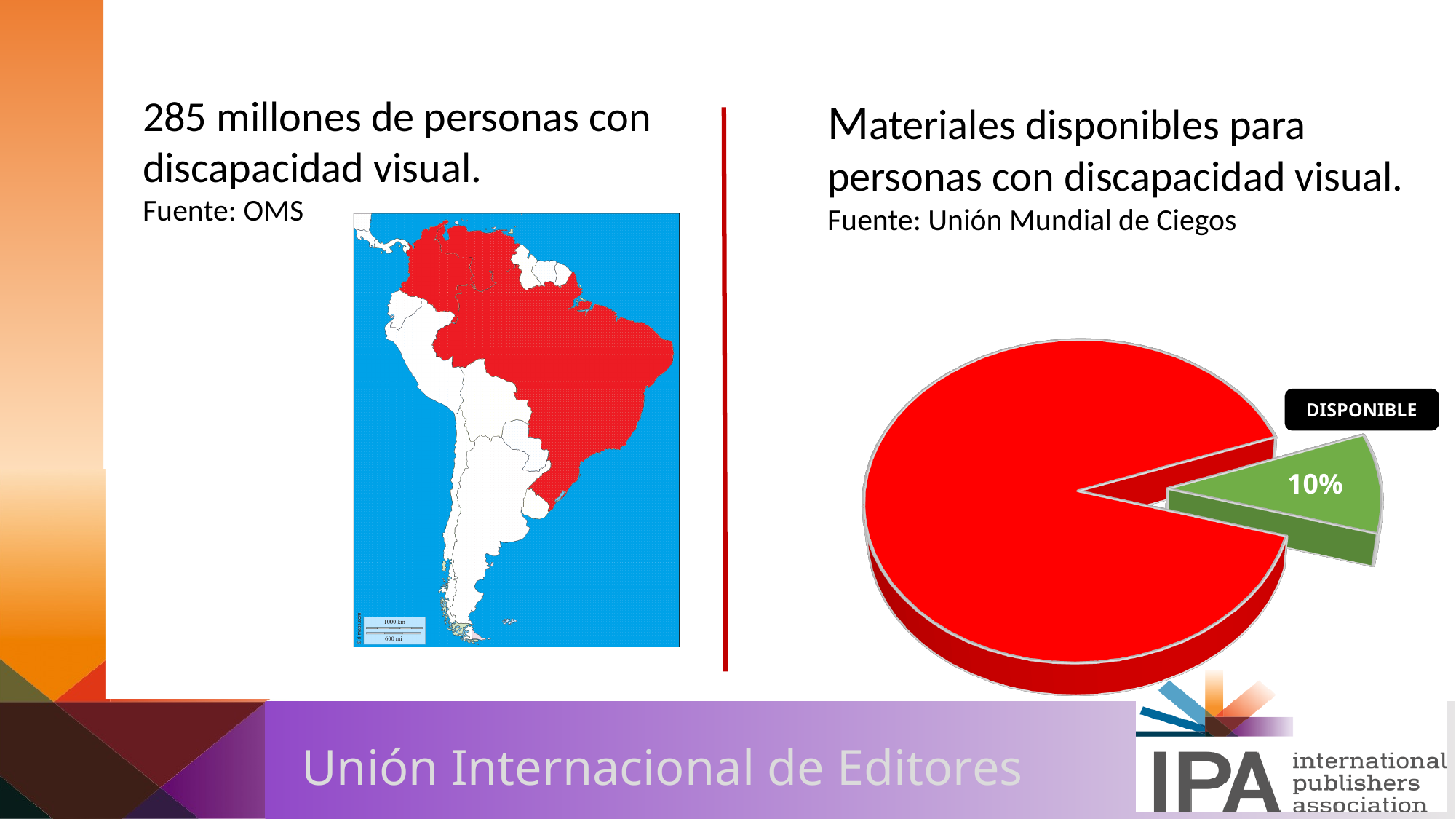
Is the value of the green slice in the pie chart greater or less than 50%? less What label is attached to the green slice of the pie chart? DISPONIBLE What colour is the slice labelled DISPONIBLE in the pie chart? Green Which slice of the pie chart is the smallest? The green DISPONIBLE slice What share of the pie does the slice labelled DISPONIBLE represent? 10% Which slice of the pie chart is the largest, the red one or the green one? The red one How many slices does the pie chart have? 2 Is the red slice of the pie chart larger or smaller than the green slice? Larger What percentage is printed on the green slice of the pie chart? 10% What kind of chart is shown on the right side of the slide? Pie chart